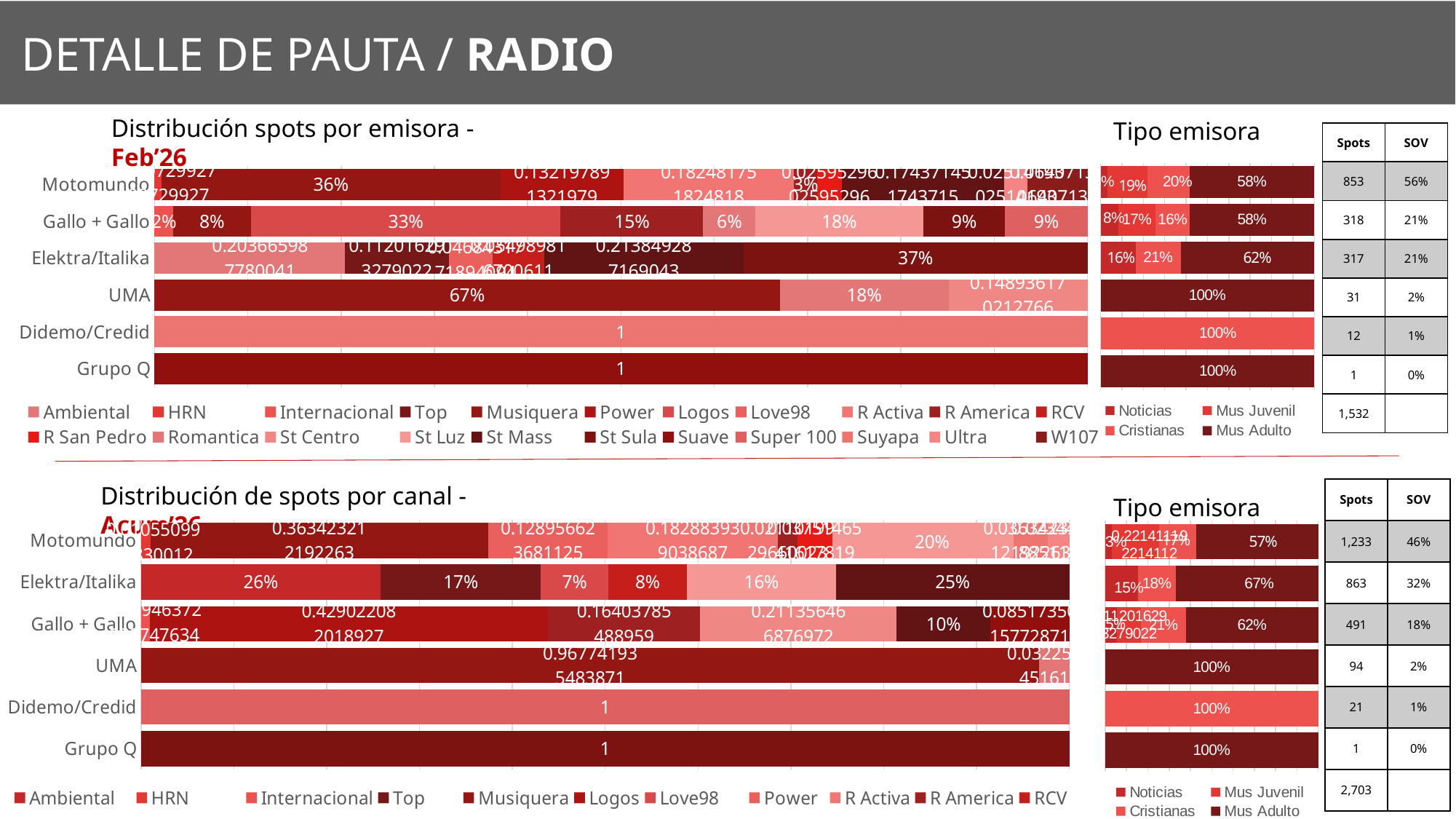
What kind of chart is the 'Distribución spots por emisora - Feb'26' chart at the top left? Stacked bar chart How many series does the legend of the bottom-left 'Distribución de spots por canal - Acum'26' chart list? 11 How many series does the legend of the top-right 'Tipo emisora' chart list? 4 In the 'Distribución de spots por canal - Acum'26' chart, what is the value of the largest segment in the Elektra/Italika bar? 26% In the 'Distribución spots por emisora - Feb'26' chart, what is the largest labelled segment in the Gallo + Gallo bar? 33% In the 'Distribución spots por emisora - Feb'26' chart, what is the value of the largest segment in the Elektra/Italika bar? 37% How many categories (rows) does the 'Distribución spots por emisora - Feb'26' chart show? 6 In the bottom-right 'Tipo emisora' chart, what is the Mus Adulto share for Elektra/Italika? 67% In the 'Distribución spots por emisora - Feb'26' chart, what is the value of the largest segment in the UMA bar? 67% In the top-right 'Tipo emisora' chart, what is the Mus Adulto share for Motomundo? 58% In the 'Distribución spots por emisora - Feb'26' chart, what is the difference between the two largest segments of the UMA bar (67% and 18%)? 49 percentage points